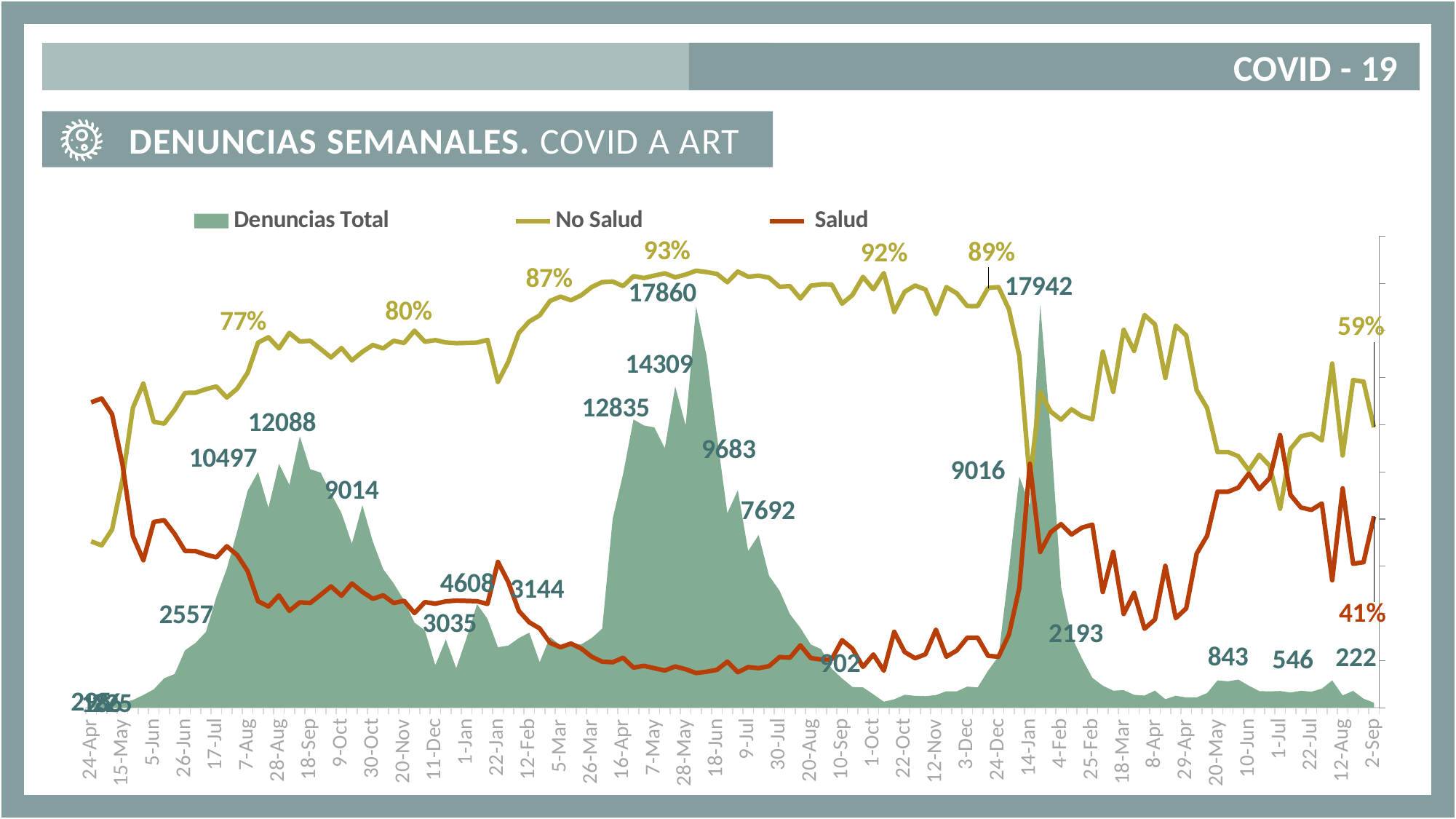
How many series does the legend list? 3 Does the Salud line rise or fall between 24-Apr and 15-May at the start of the chart? Fall What is the difference between the two highest labeled Denuncias Total values, 17942 and 17860? 82 What is the difference between the labeled Denuncias Total values 14309 and 12835? 1474 Which labeled Denuncias Total value is larger, 12088 or 12835? 12835 What are the three series named in the legend? Denuncias Total, No Salud, Salud What kind of chart is this? A combined area and line chart What is the last labeled percentage for the No Salud series at the right end of the chart? 59% What is the highest labeled value of Denuncias Total? 17942 What is the highest percentage label shown for the No Salud series? 93% What is the last labeled value of Denuncias Total at the right end of the chart? 222 What is the last labeled percentage for the Salud series at the right end of the chart? 41%